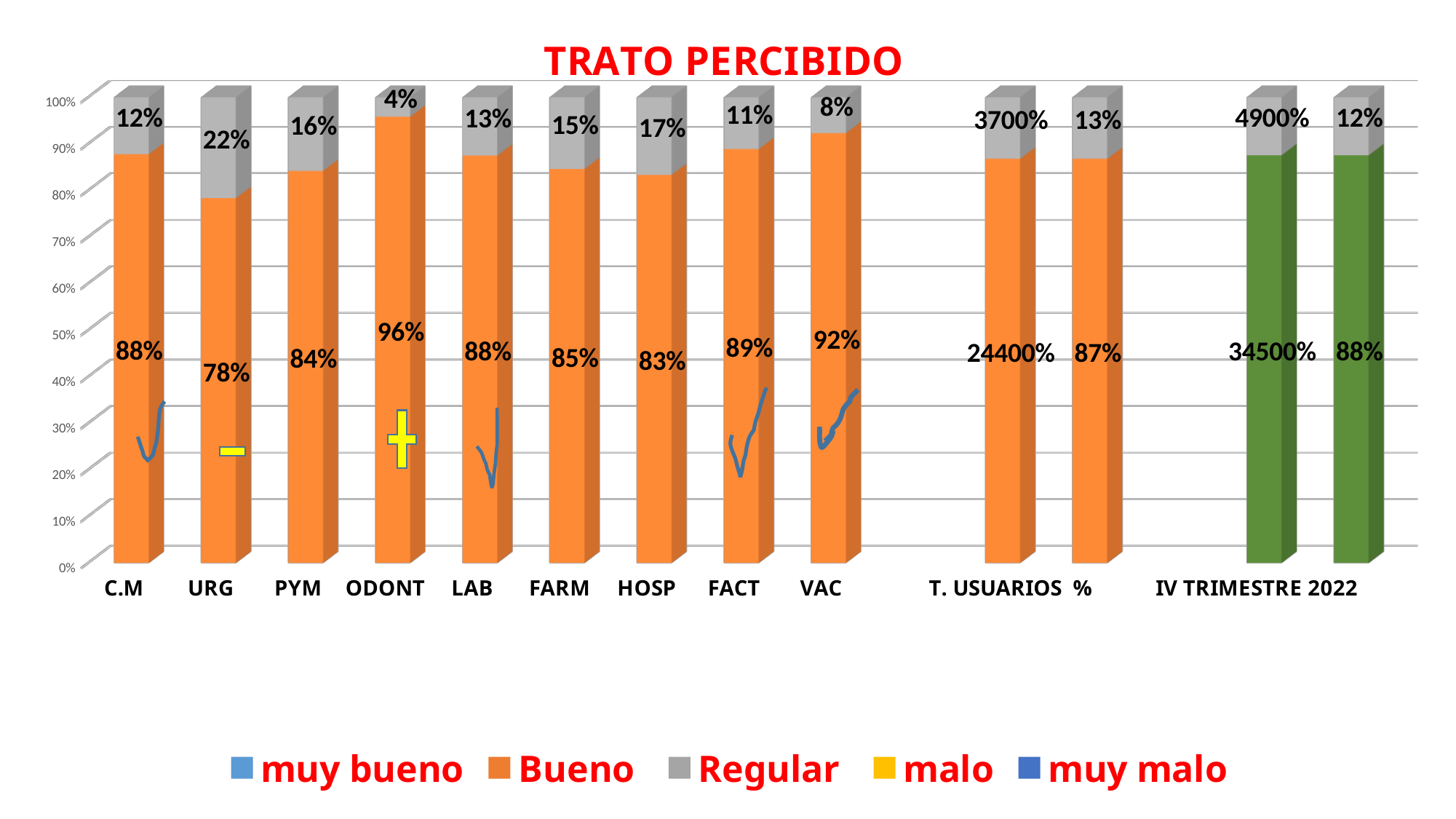
What is the Regular value for HOSP? 17% What is the title of the chart? TRATO PERCIBIDO Which category has the lowest Regular value? ODONT Which has a larger Bueno value, FACT or FARM? FACT How many series does the legend list? 5 What is the Bueno value for VAC? 92% What is the difference between the Bueno values for VAC and URG? 14% What is the Regular value for URG? 22% Which category has the lowest Bueno value? URG What kind of chart is shown on the slide? Stacked bar chart What is the Bueno value for ODONT? 96%